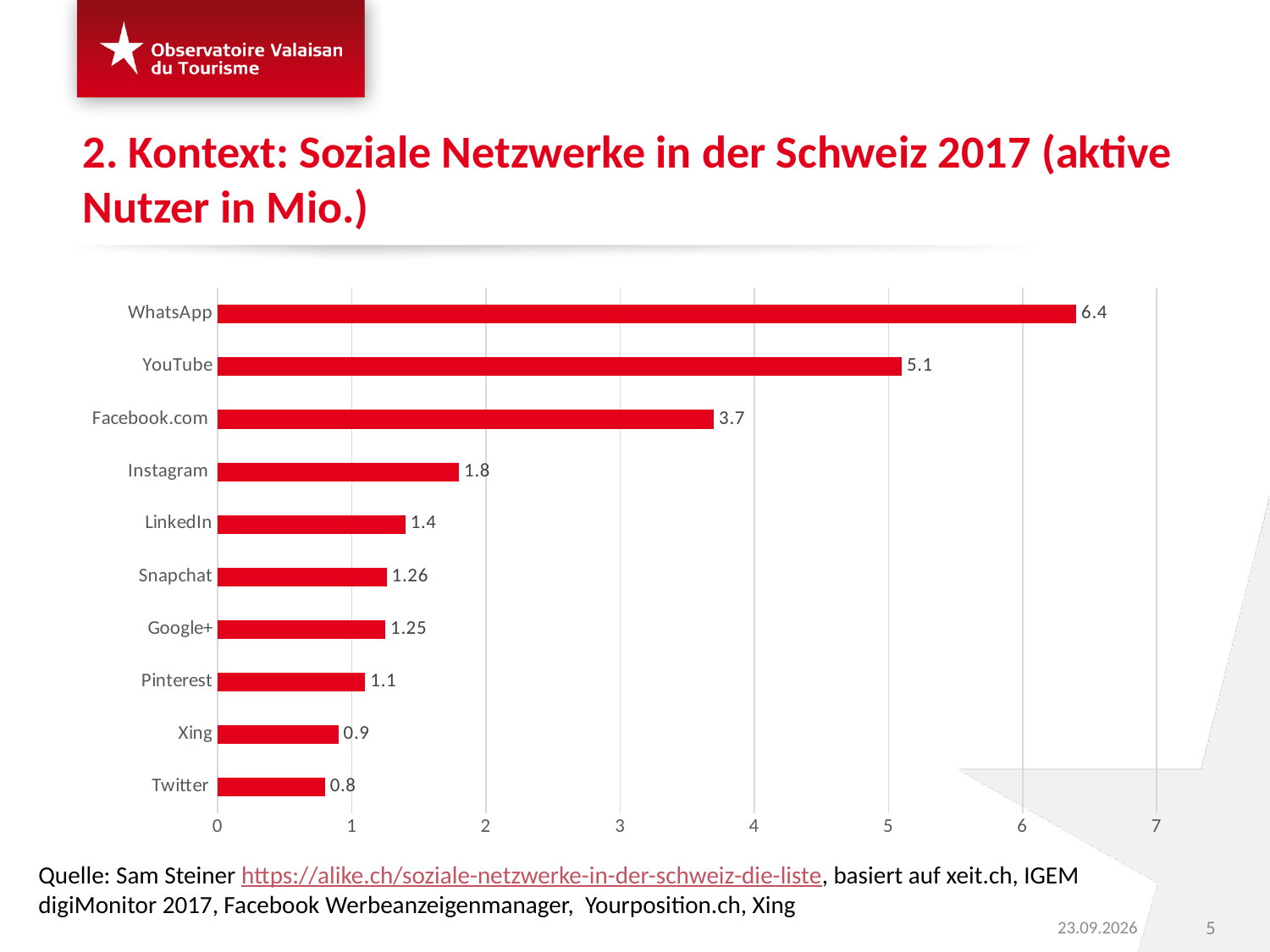
What is the value for Snapchat? 1.26 Which social network has the highest value? WhatsApp What kind of chart is shown on the slide? bar chart What is the value for WhatsApp? 6.4 What is the highest value shown on the horizontal axis? 7 Is the value for Facebook.com greater or less than 4? less What is the value for Pinterest? 1.1 Which has a larger value, LinkedIn or Xing? LinkedIn Which social network has the lowest value? Twitter What is the difference between the values for Facebook.com and Instagram? 1.9 How many social networks are shown in the chart? 10 What is the difference between the values for WhatsApp and YouTube? 1.3